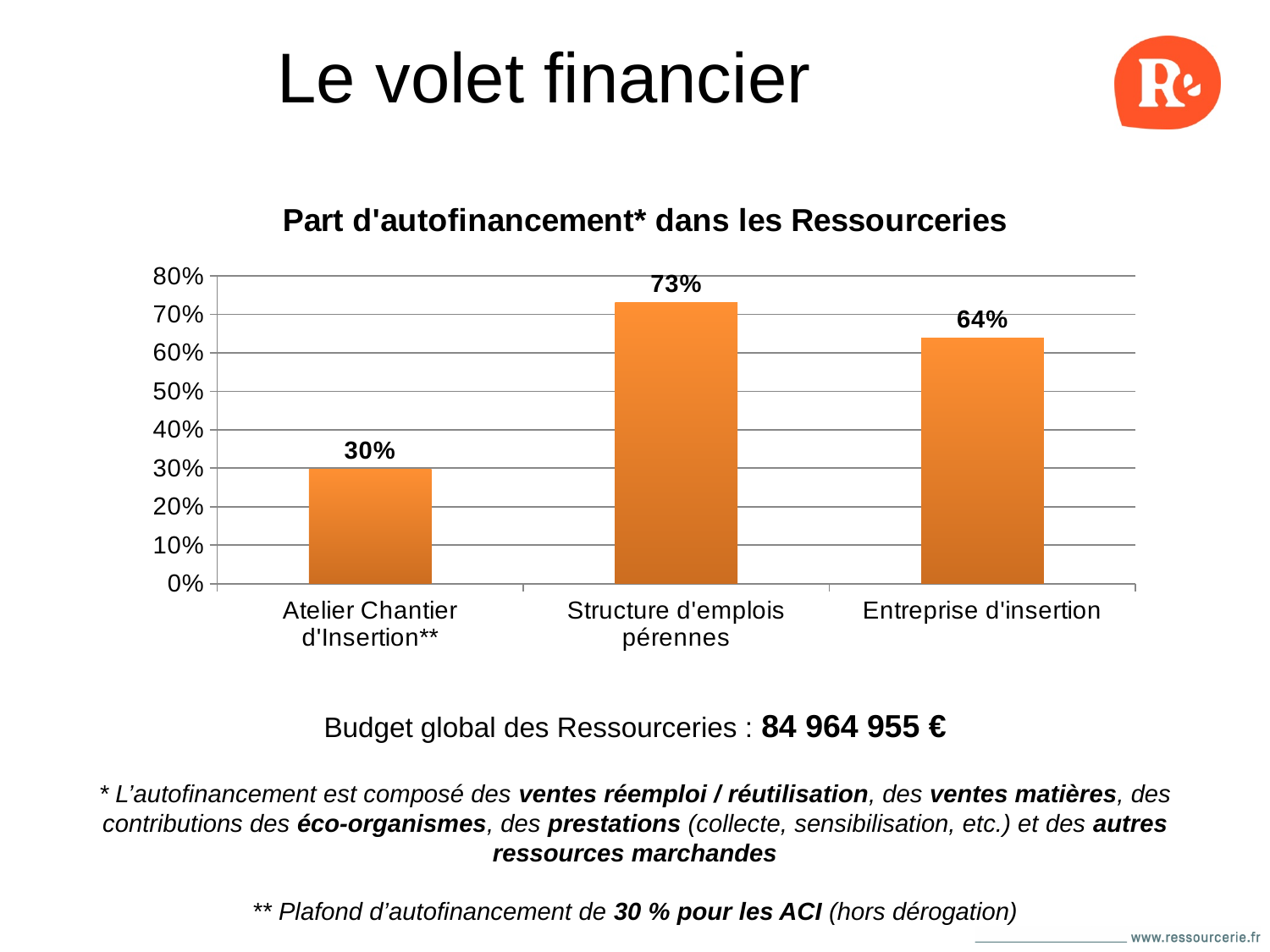
Which is larger, the value for Structure d'emplois pérennes or the value for Entreprise d'insertion? Structure d'emplois pérennes Which category has the lowest share of self-financing? Atelier Chantier d'Insertion** What kind of chart is shown on the slide? Bar chart How many categories are shown in the chart? 3 What is the title of the chart? Part d'autofinancement* dans les Ressourceries What is the difference between the values for Structure d'emplois pérennes and Entreprise d'insertion? 9% What is the value for Entreprise d'insertion? 64% Which category has the highest share of self-financing? Structure d'emplois pérennes Is the value for Entreprise d'insertion greater or less than 50%? greater What is the difference between the values for Entreprise d'insertion and Atelier Chantier d'Insertion**? 34% What is the value for Atelier Chantier d'Insertion**? 30% What is the value for Structure d'emplois pérennes? 73%